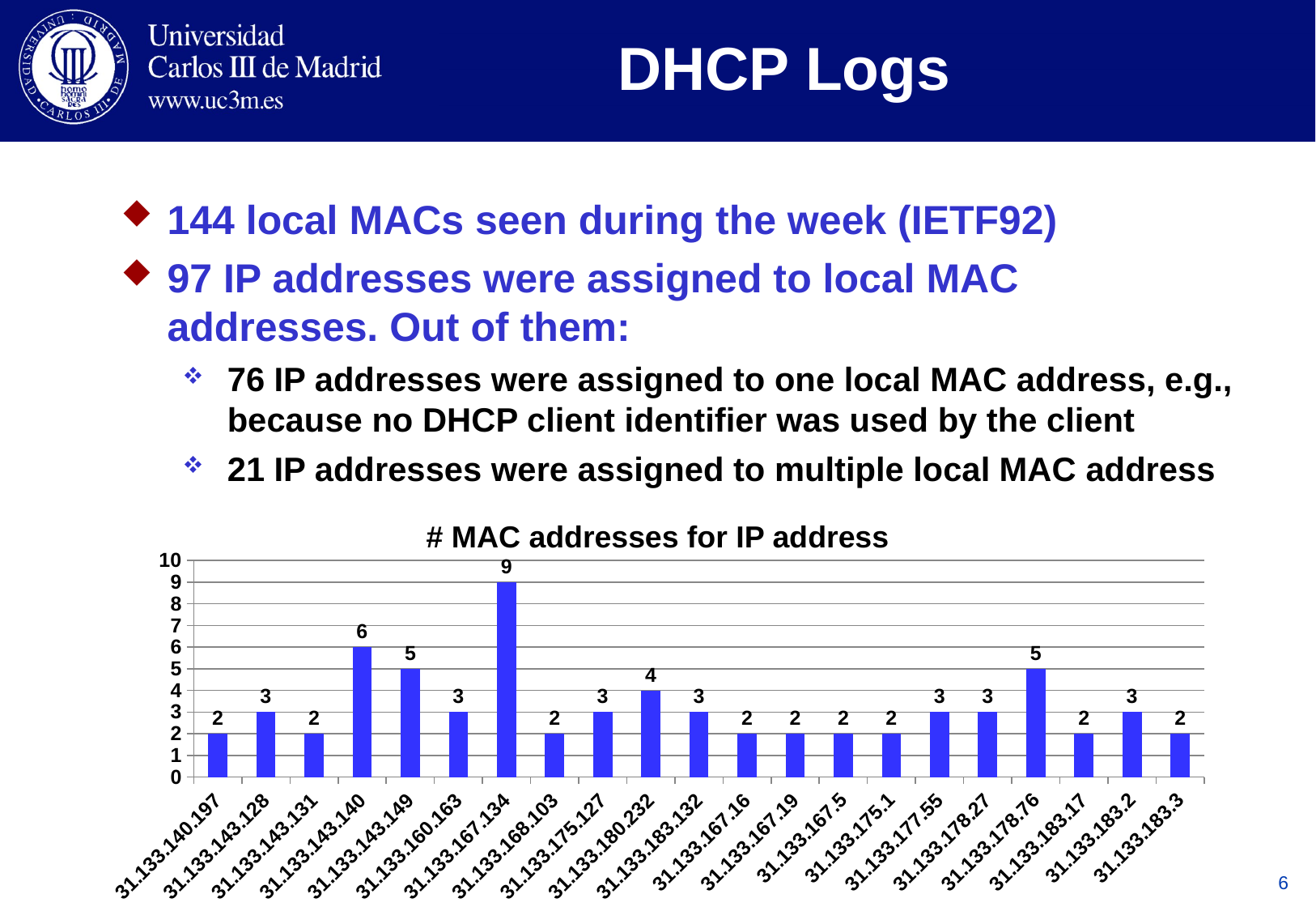
What is the value for 31.133.167.134? 9 How many IP addresses (bars) are plotted in the chart? 21 What type of chart is shown on the slide? bar chart What is the maximum value shown on the vertical axis? 10 What is the value for 31.133.180.232? 4 Which IP address has the highest number of MAC addresses? 31.133.167.134 What is the difference between the values for 31.133.167.134 and 31.133.143.140? 3 What is the value for 31.133.143.140? 6 What is the lowest value shown in the chart? 2 What is the value for 31.133.178.76? 5 Which has a larger value, 31.133.143.149 or 31.133.160.163? 31.133.143.149 What is the title of the chart? # MAC addresses for IP address